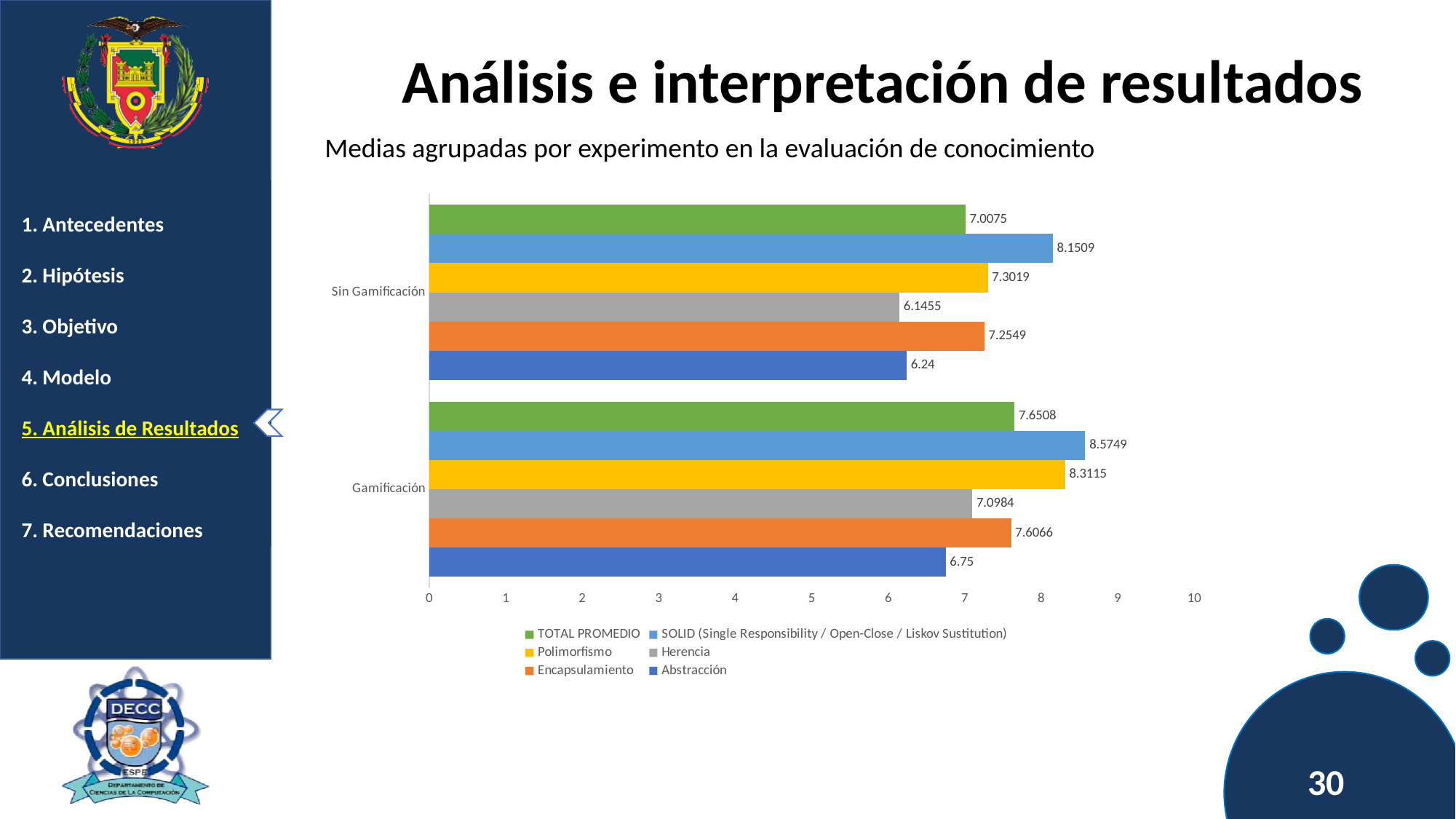
What is the value of Polimorfismo for Sin Gamificación? 7.3019 What kind of chart is shown on the slide? Bar chart What is the difference between the SOLID values for Gamificación and Sin Gamificación? 0.424 How many series does the legend list? 6 How many categories are shown on the vertical axis? 2 Is the value of Polimorfismo for Gamificación greater or less than 8? greater What is the value of Herencia for Sin Gamificación? 6.1455 What is the value of Abstracción for Gamificación? 6.75 What is the value of TOTAL PROMEDIO for Gamificación? 7.6508 Which series has the lowest value for Sin Gamificación? Herencia Which series has the highest value for Gamificación? SOLID (Single Responsibility / Open-Close / Liskov Sustitution) Which is larger, Encapsulamiento for Gamificación or Encapsulamiento for Sin Gamificación? Encapsulamiento for Gamificación